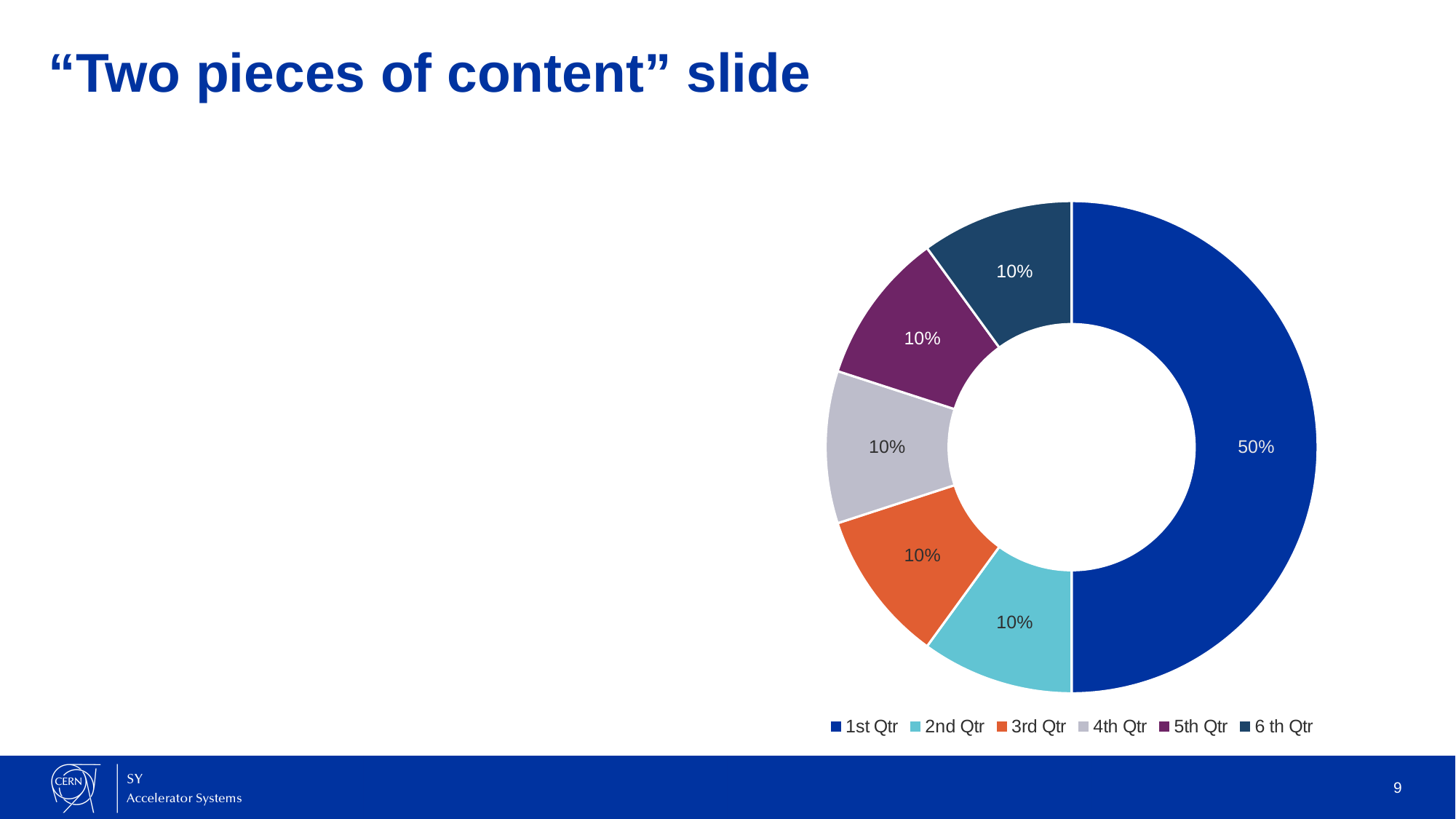
What is the difference between the 1st Qtr and 3rd Qtr values? 40% Which legend entry is listed last? 6 th Qtr Which category has the largest slice in the doughnut chart? 1st Qtr What share of the doughnut chart does 1st Qtr represent? 50% What is the value shown for 4th Qtr? 10% Which is larger, the 1st Qtr slice or the 5th Qtr slice? 1st Qtr What kind of chart is shown on the slide? Doughnut chart How many entries does the legend list? 6 What colour is the 3rd Qtr slice? Orange How many categories does the doughnut chart have? 6 What is the value shown for 6 th Qtr? 10% What share of the doughnut chart does 2nd Qtr represent? 10%